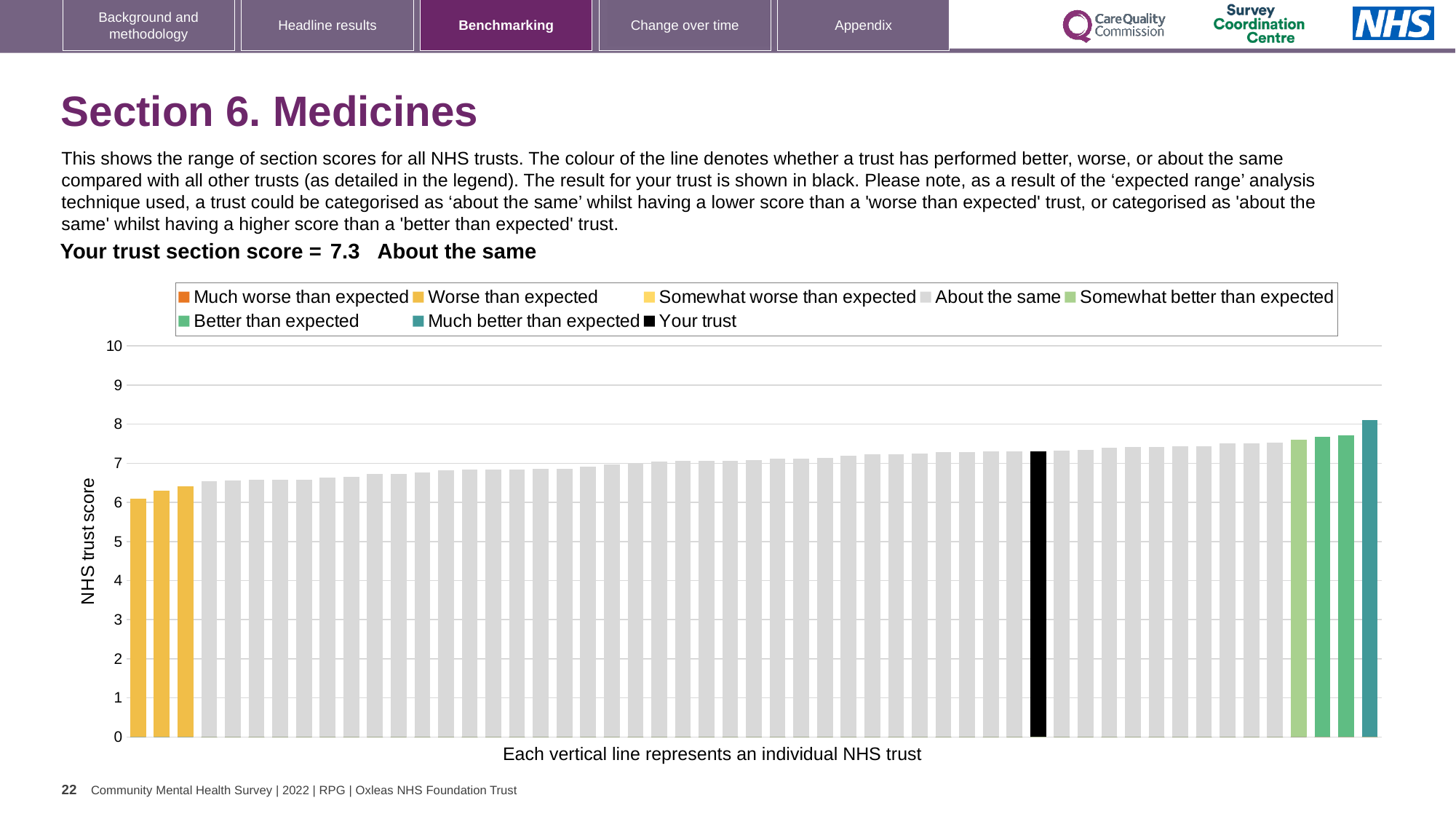
Is the value for your trust greater or less than 7? greater What is the section score for your trust shown on the slide? 7.3 Is the value of the lowest-scoring trust (leftmost bar) greater or less than 7? less Do the bar values rise or fall from left to right along the x axis? rise Which is larger: the score of your trust (black bar) or the score of the leftmost bar? your trust How many trusts are shown as 'Much better than expected' (teal bars)? 1 What is the label on the y axis of the chart? NHS trust score How many trusts are shown as 'Worse than expected' (yellow bars)? 3 How many entries does the chart legend list? 8 Which legend category does the highest bar on the chart belong to? Much better than expected Is the value of the highest-scoring trust (rightmost bar) greater or less than 7? greater What kind of chart is shown on the slide? bar chart